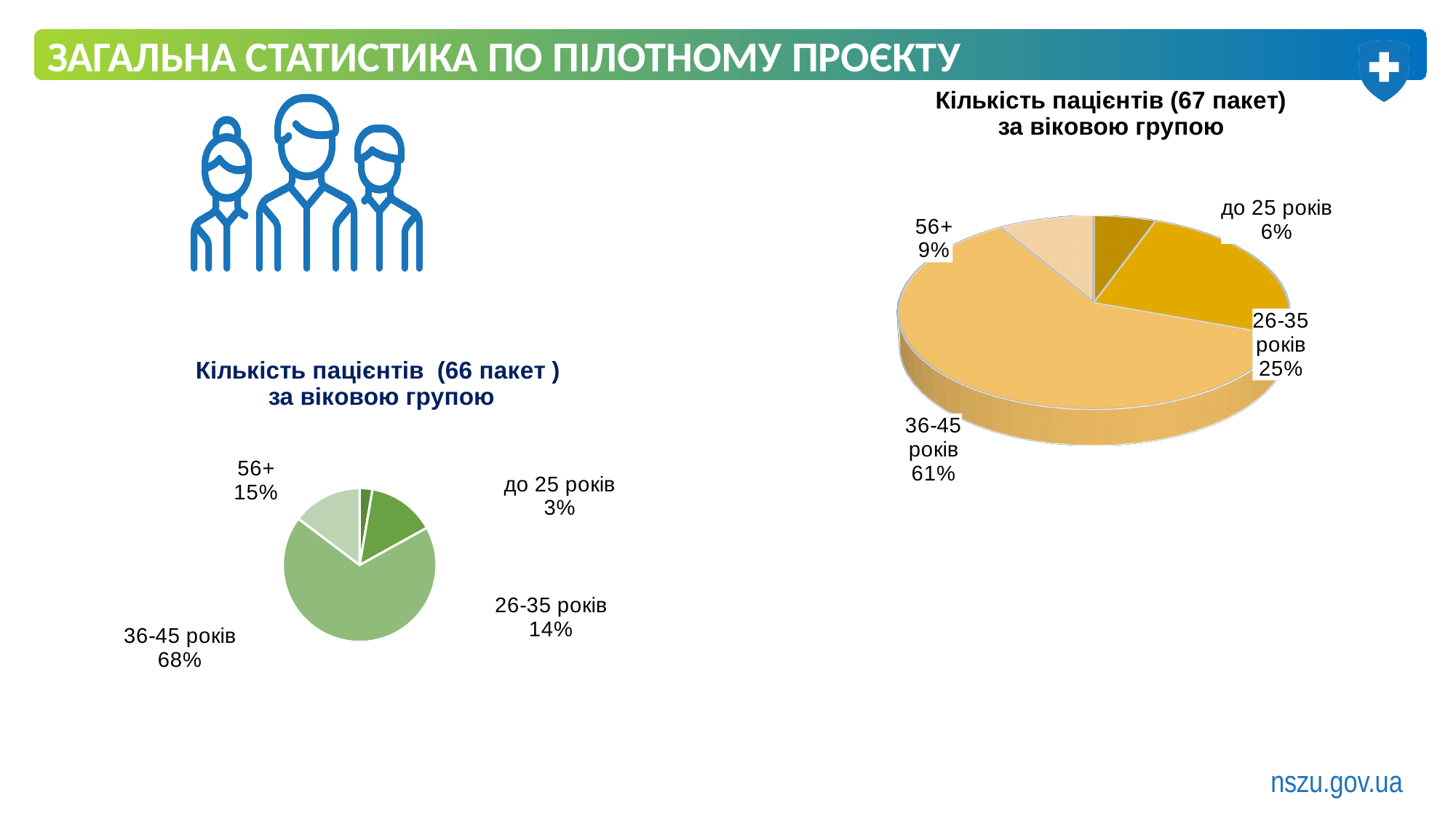
In the chart titled 'Кількість пацієнтів (67 пакет) за віковою групою', what is the difference in percentage points between the 36-45 років and 26-35 років shares? 36 In the chart titled 'Кількість пацієнтів (67 пакет) за віковою групою', which age group has the smallest share? до 25 років In the chart titled 'Кількість пацієнтів (66 пакет) за віковою групою', which age group has the smallest share? до 25 років In the chart titled 'Кількість пацієнтів (66 пакет) за віковою групою', what share do patients aged до 25 років have? 3% In the chart titled 'Кількість пацієнтів (66 пакет) за віковою групою', what share do patients aged 36-45 років have? 68% In the chart titled 'Кількість пацієнтів (67 пакет) за віковою групою', what share do patients aged 26-35 років have? 25% In the chart titled 'Кількість пацієнтів (66 пакет) за віковою групою', which age group has the largest share? 36-45 років What colour scheme is used for the slices in the chart titled 'Кількість пацієнтів (67 пакет) за віковою групою'? Shades of orange/yellow In the chart titled 'Кількість пацієнтів (67 пакет) за віковою групою', what share do patients aged 56+ have? 9% How many age groups are shown in the chart titled 'Кількість пацієнтів (67 пакет) за віковою групою'? 4 In the chart titled 'Кількість пацієнтів (66 пакет) за віковою групою', which is larger: the share for 56+ or the share for 26-35 років? 56+ What type of chart is the one titled 'Кількість пацієнтів (66 пакет) за віковою групою'? Pie chart